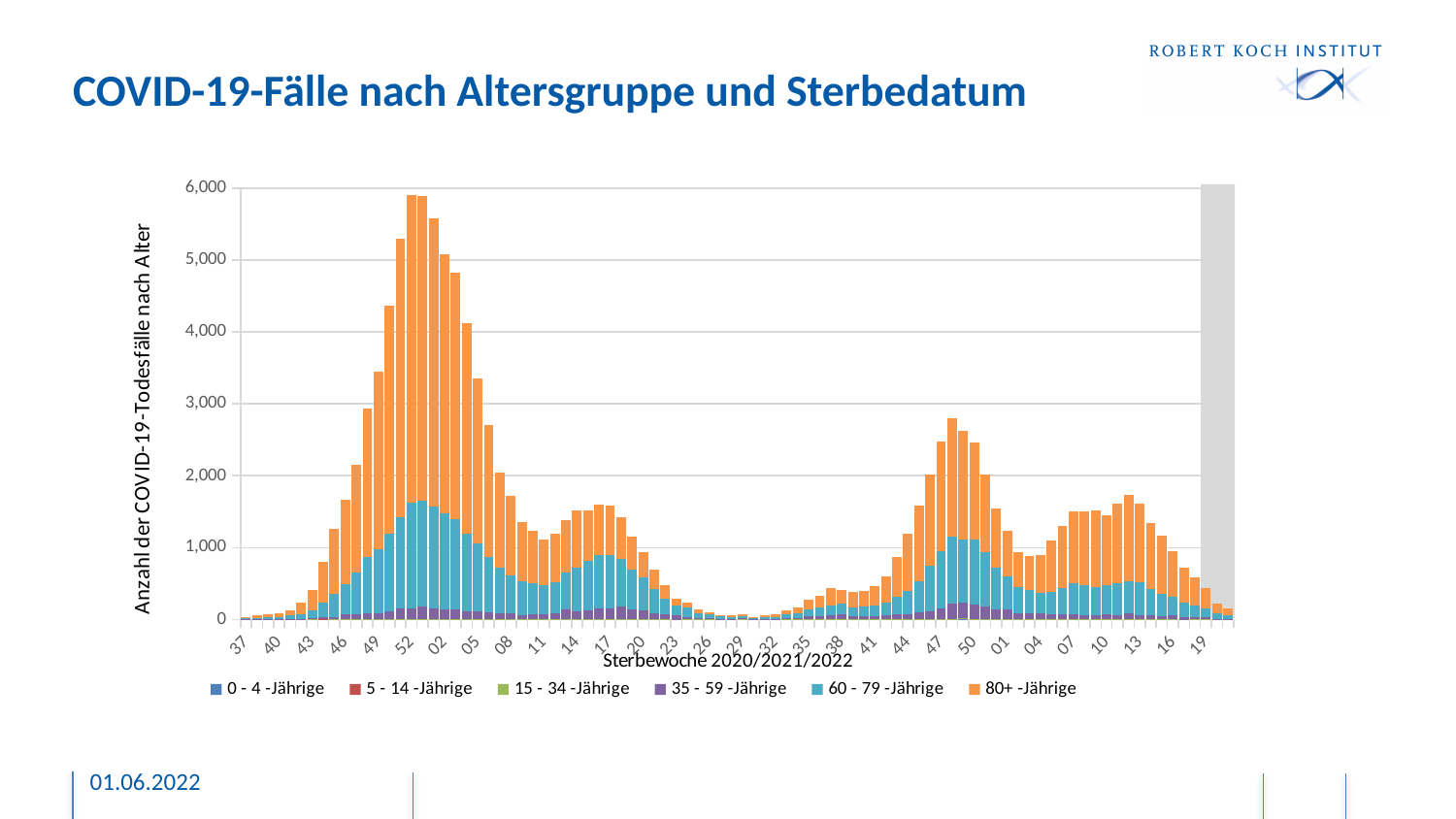
What kind of chart is shown on the slide? Stacked bar chart Which age group is shown in orange in the legend? 80+ -Jährige Which age group accounts for the largest part of the tallest bars around Sterbewoche 52? 80+ -Jährige Which is larger, the total value for Sterbewoche 52 or for Sterbewoche 26? Sterbewoche 52 Is the total value for Sterbewoche 10 greater or less than 1,000? greater Is the total value for Sterbewoche 52 greater or less than 5,000? greater What is the title of the chart? COVID-19-Fälle nach Altersgruppe und Sterbedatum Is the total value for Sterbewoche 47 greater or less than 2,000? greater How many series does the legend list? 6 Do the total values rise or fall from Sterbewoche 37 to Sterbewoche 52? rise